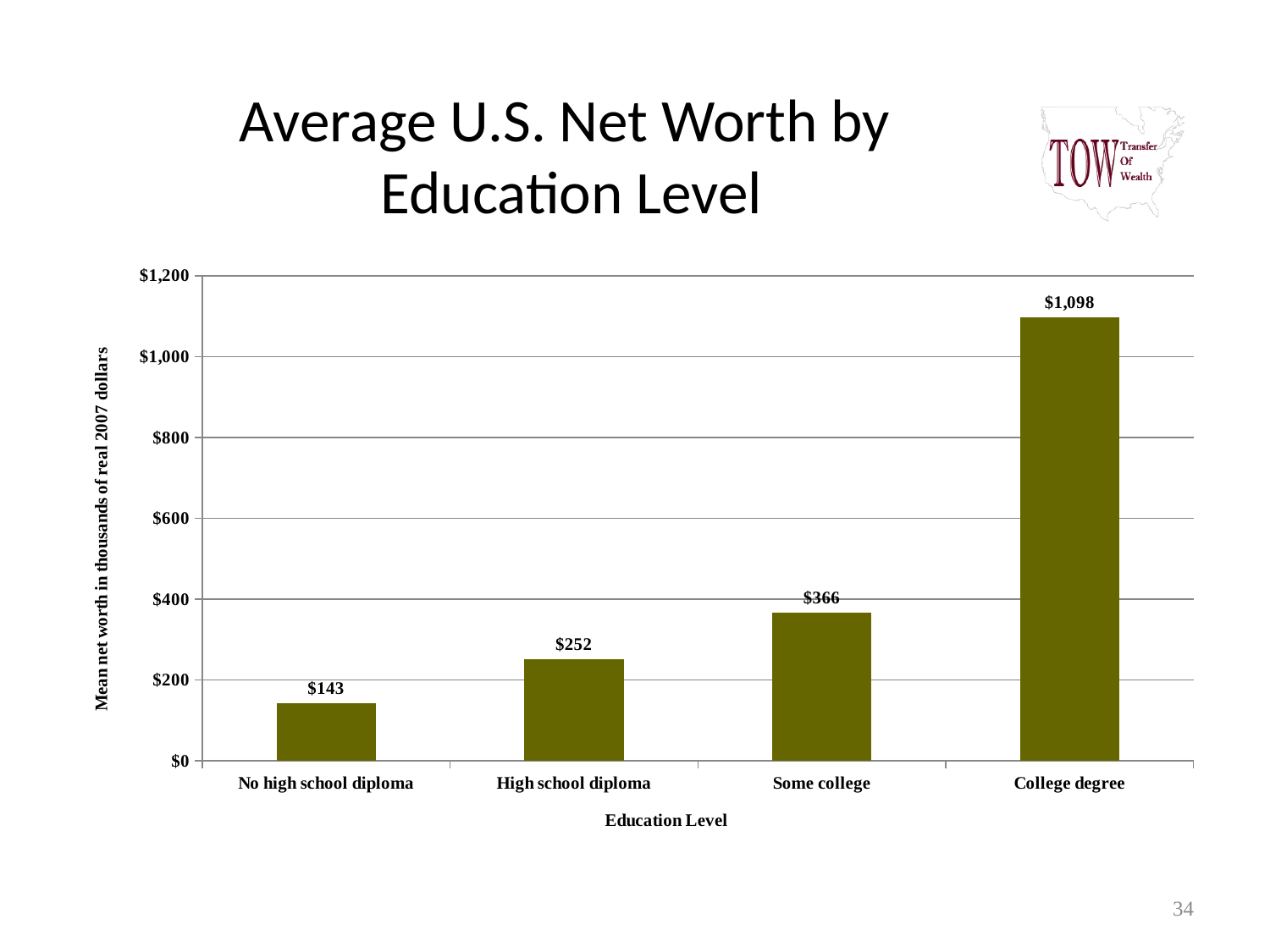
What kind of chart is shown on the slide? Bar chart Which education level has the highest mean net worth? College degree What is the value shown for 'Some college'? $366 Which is larger, the value for 'High school diploma' or the value for 'Some college'? Some college What is the mean net worth for the 'College degree' category? $1,098 What is the mean net worth for the 'No high school diploma' category? $143 What is the label of the vertical axis? Mean net worth in thousands of real 2007 dollars How many education level categories are shown in the chart? 4 Which education level has the lowest mean net worth? No high school diploma What is the difference between the values for 'High school diploma' and 'No high school diploma'? $109 What is the difference between the values for 'College degree' and 'Some college'? $732 Is the value for 'College degree' greater or less than $1,000? greater